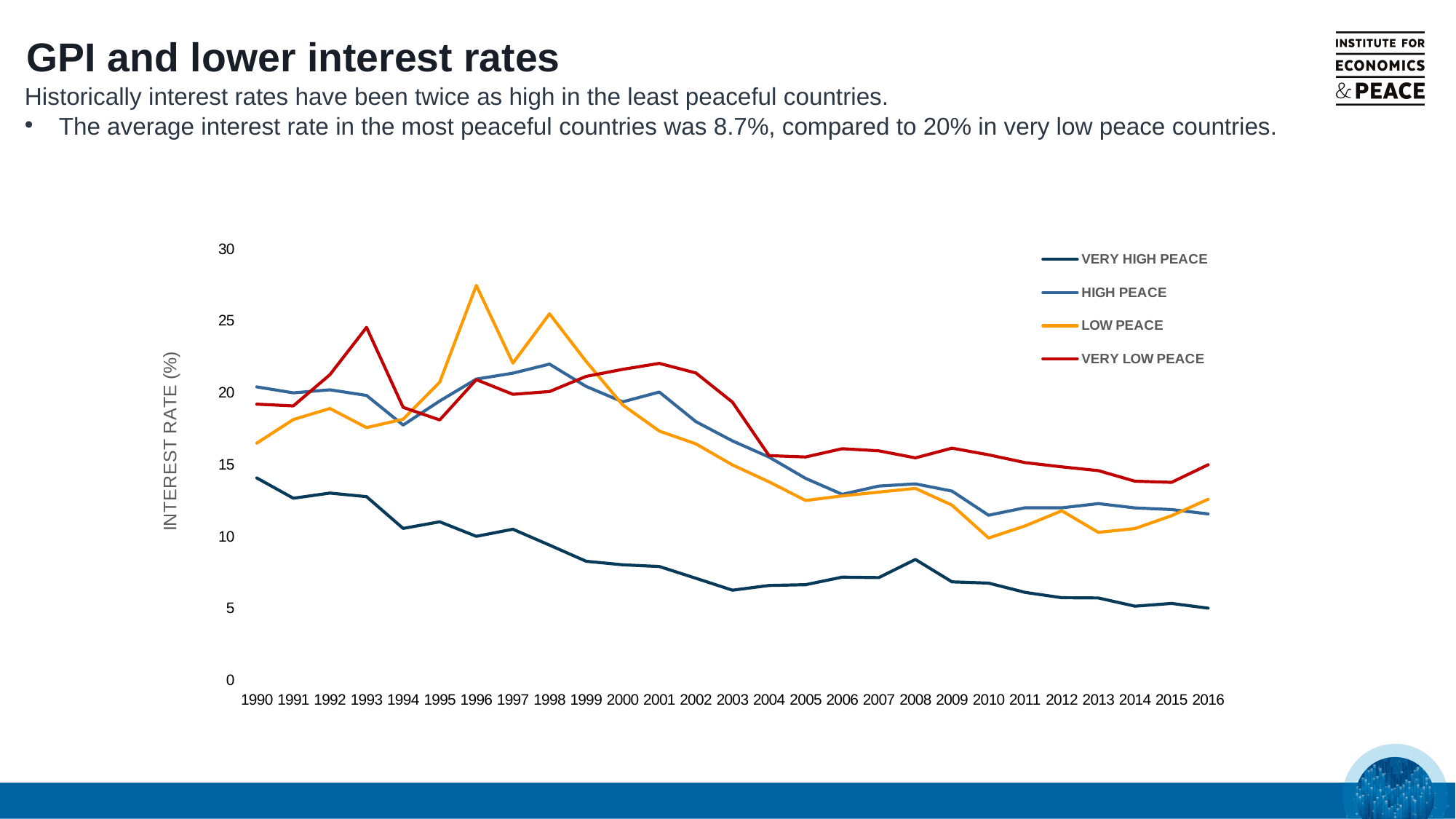
Which series has the lowest value in 2010? VERY HIGH PEACE Is the value for LOW PEACE in 1996 greater or less than 25? greater Does the VERY HIGH PEACE line rise or fall from 1990 to 2016? Fall In 2016, which is larger: the VERY HIGH PEACE value or the VERY LOW PEACE value? VERY LOW PEACE Is the value for VERY LOW PEACE in 2016 greater or less than 20? less Which series has the highest value in 1996? LOW PEACE What is the title of the chart's vertical axis? INTEREST RATE (%) How many years are shown along the x axis of the chart? 27 Is the value for VERY HIGH PEACE in 1990 greater or less than 10? greater What kind of chart is shown on the slide? Line chart How many series does the chart's legend list? 4